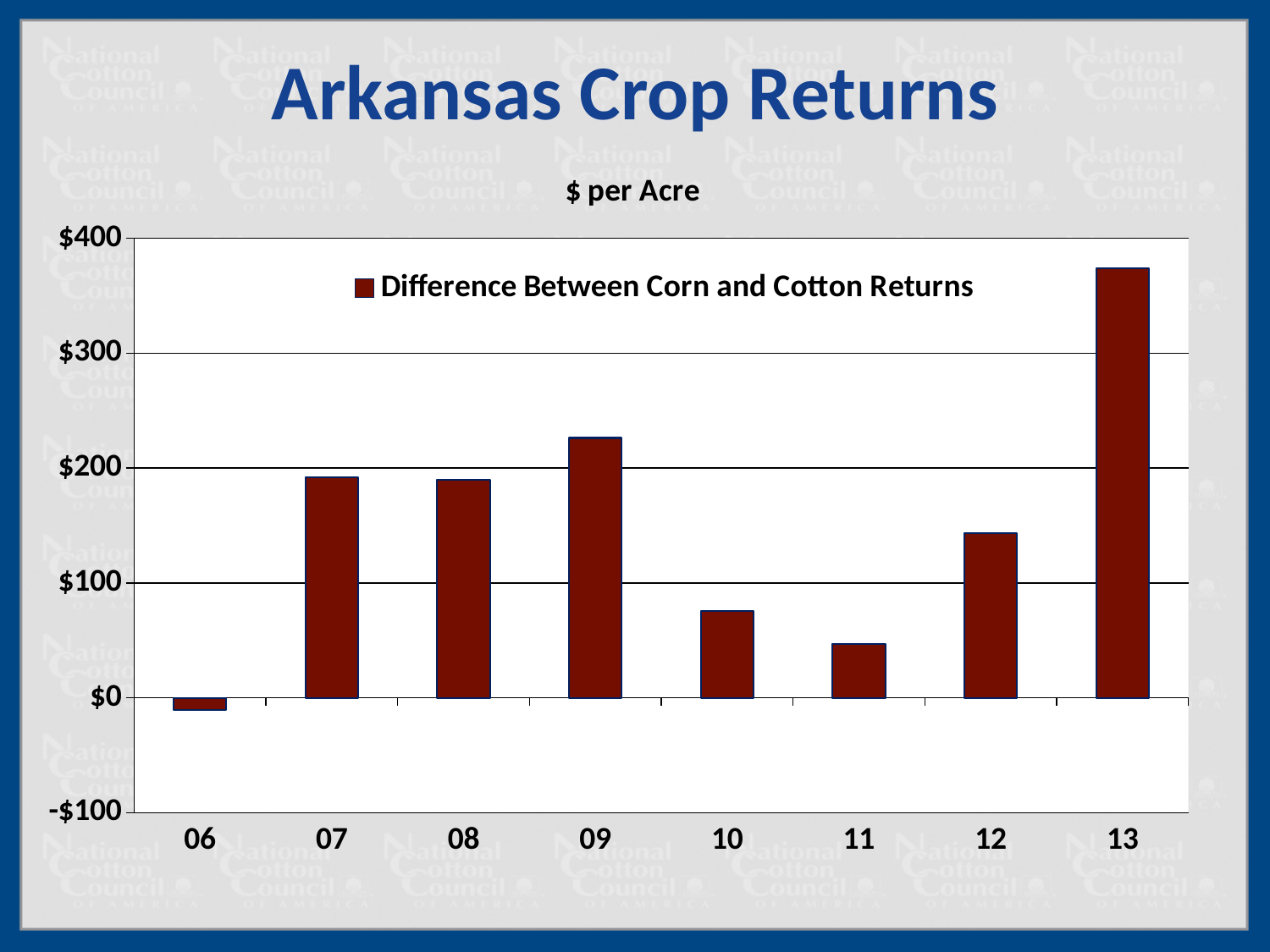
Is the value for 11 greater or less than $100? less What is the title of the slide? Arkansas Crop Returns How many series does the chart's legend list? 1 Is the value for 13 greater or less than $300? greater Which year has the highest difference between corn and cotton returns? 13 How many years are shown on the x axis of the chart? 8 Is the value for 09 greater or less than $200? greater Which year has the larger value, 10 or 11? 10 Which year has the larger value, 09 or 12? 09 What kind of chart is shown on the slide? bar chart Which year has the lowest difference between corn and cotton returns? 06